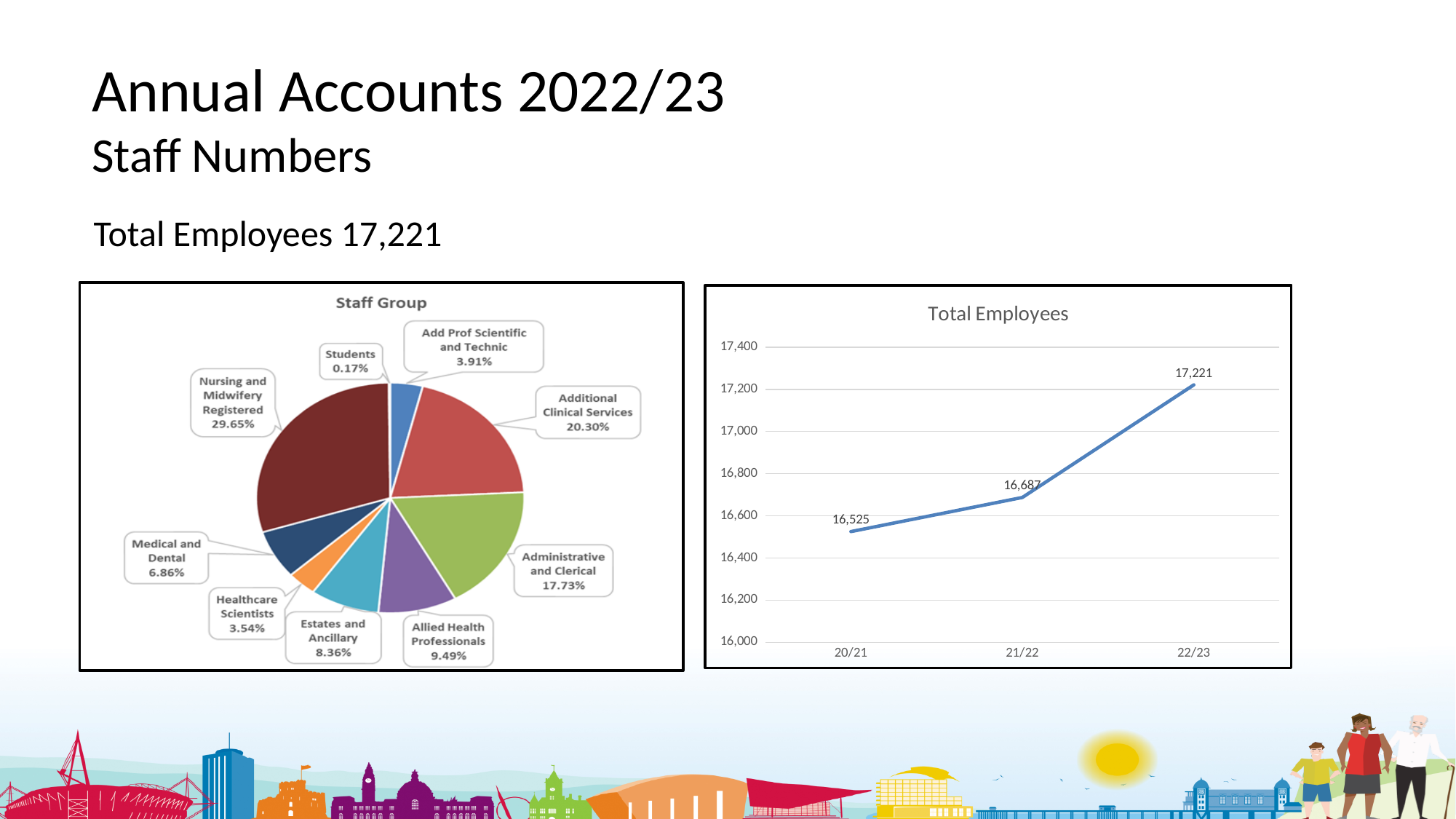
In the Total Employees chart, do the values rise or fall from 20/21 to 22/23? Rise In the Total Employees chart, what is the difference between the 22/23 and 20/21 values? 696 In the Staff Group pie chart, which staff group has the largest share? Nursing and Midwifery Registered In the Staff Group pie chart, what is the difference in percentage points between Estates and Ancillary and Healthcare Scientists? 4.82 In the Staff Group pie chart, what percentage is shown for Additional Clinical Services? 20.30% In the Staff Group pie chart, how many staff groups are shown? 9 In the Total Employees chart, how many years are plotted? 3 In the Staff Group pie chart, which is larger: Administrative and Clerical or Allied Health Professionals? Administrative and Clerical In the Staff Group pie chart, what share of staff is Nursing and Midwifery Registered? 29.65% In the Staff Group pie chart, which staff group has the smallest share? Students What kind of chart is the Total Employees chart on the right? Line chart In the Total Employees chart, what is the value for 21/22? 16,687